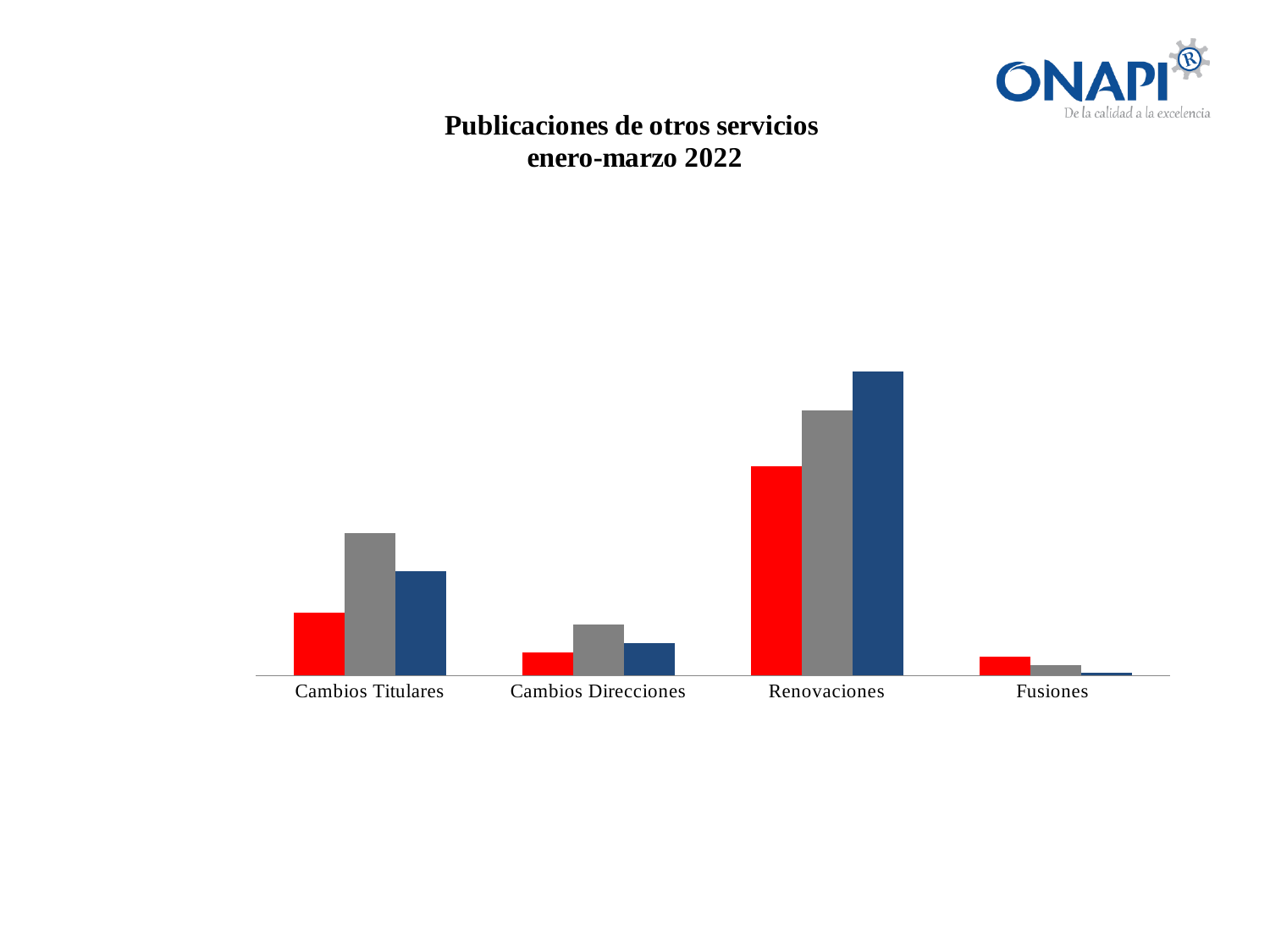
In the Renovaciones category, which bar is the tallest: the red, the grey or the blue one? Blue Which category has the shortest bars in the chart? Fusiones How many bars are plotted for each category in the chart? 3 Which category has the tallest bars in the chart? Renovaciones Which category has higher values, Cambios Titulares or Cambios Direcciones? Cambios Titulares What kind of chart is shown on the slide? Bar chart How many categories are shown on the x axis of the chart? 4 What is the title of the chart? Publicaciones de otros servicios enero-marzo 2022 In the Cambios Titulares category, which bar is the tallest: the red, the grey or the blue one? Grey Does the chart display a legend identifying the three bar colours? No